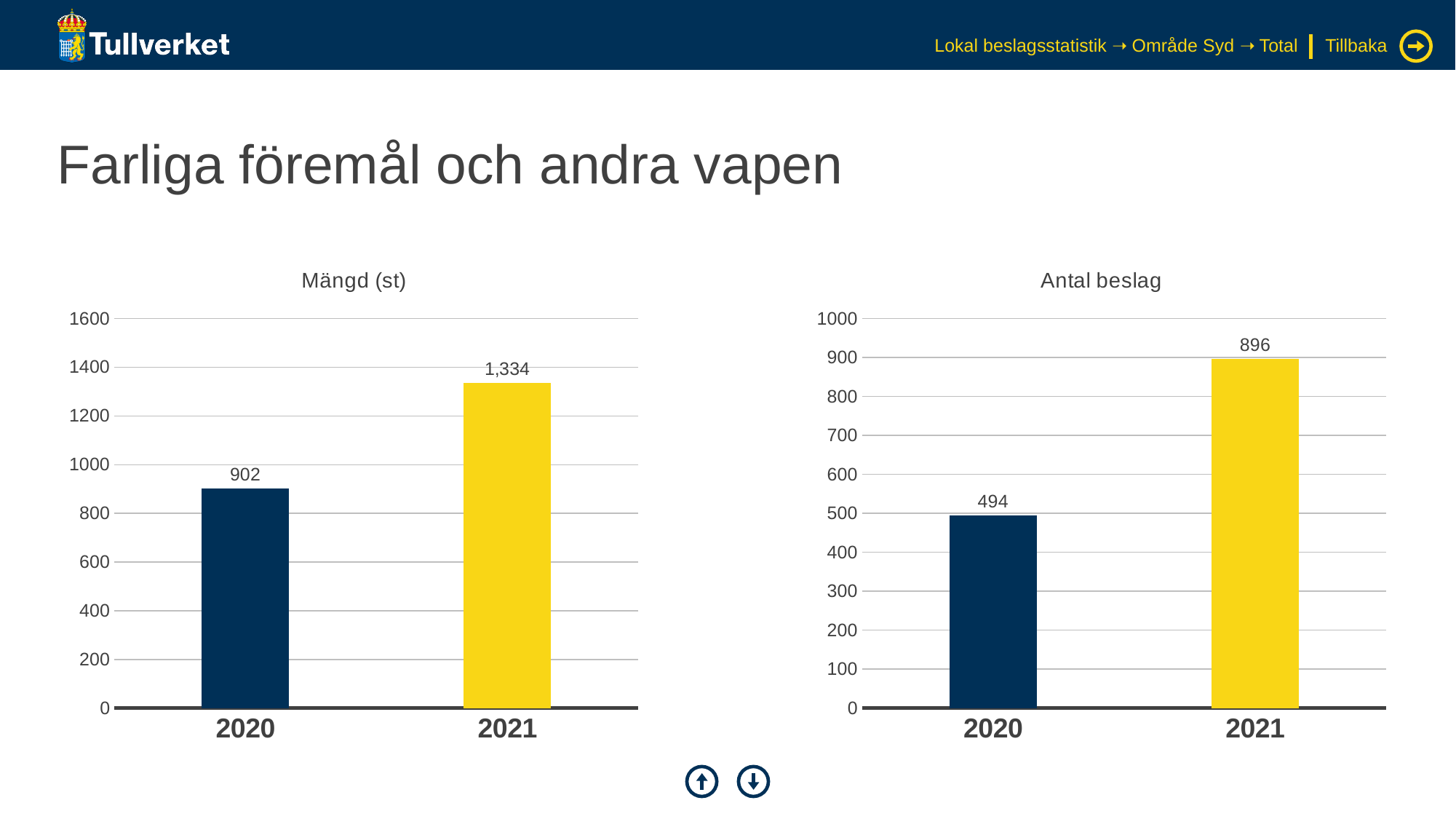
In the 'Mängd (st)' chart, what is the difference between the 2021 and 2020 values? 432 How many years are shown in the 'Mängd (st)' chart? 2 In the 'Antal beslag' chart, is the value for 2020 greater or less than 500? less In the 'Mängd (st)' chart, which year has the highest value? 2021 In the 'Mängd (st)' chart, what is the value for 2020? 902 In the 'Antal beslag' chart, which year has the lowest value? 2020 What kind of chart is the 'Antal beslag' chart? bar chart In the 'Antal beslag' chart, what is the value for 2020? 494 In the 'Antal beslag' chart, what is the difference between the 2021 and 2020 values? 402 In the 'Mängd (st)' chart, do the values rise or fall from 2020 to 2021? rise In the 'Mängd (st)' chart, what is the value for 2021? 1,334 In the 'Antal beslag' chart, what is the value for 2021? 896